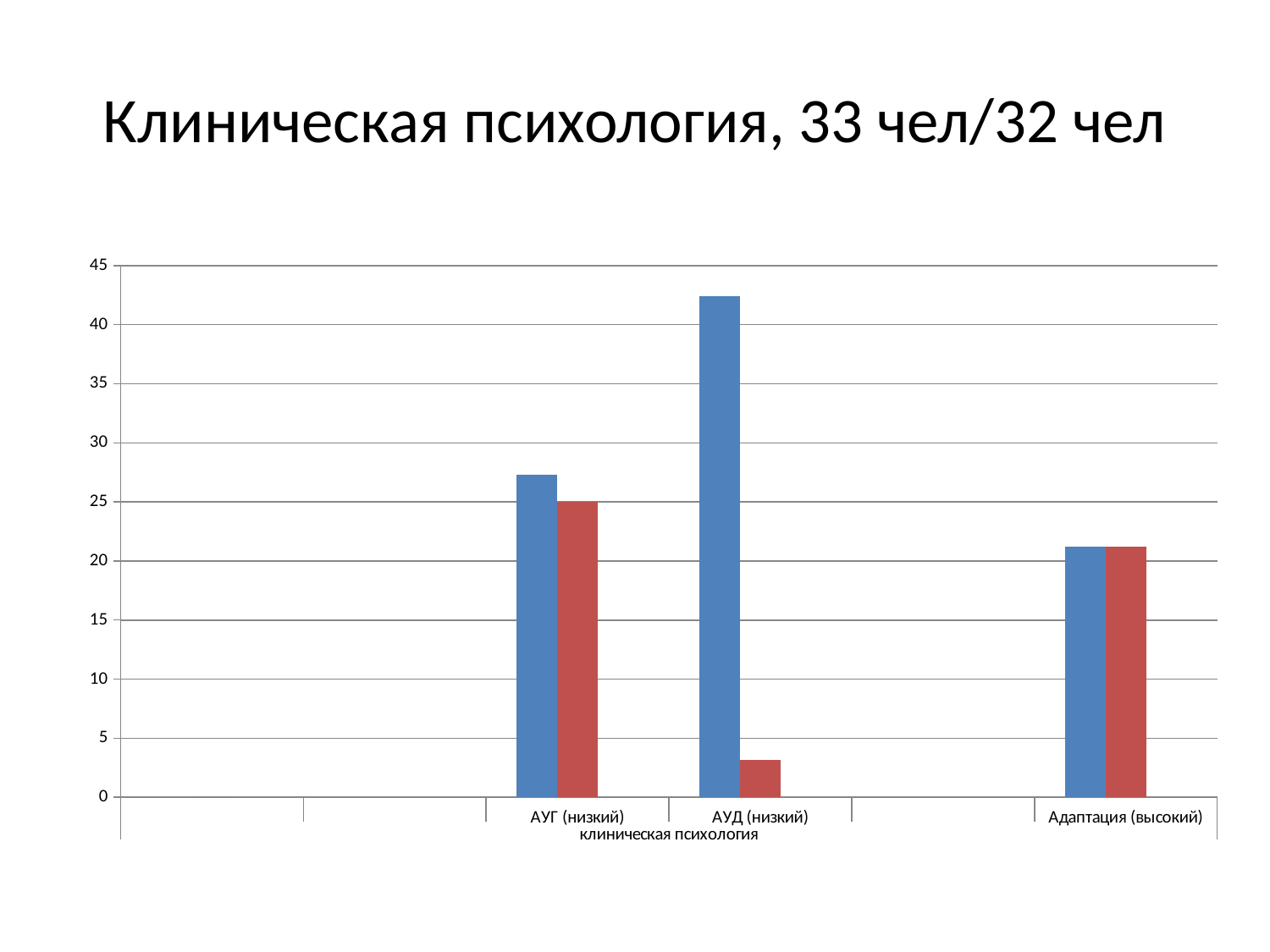
Which category has the tallest blue bar? АУД (низкий) What kind of chart is shown on the slide? Bar chart For АУД (низкий), which bar is taller, the blue one or the red one? The blue one For АУГ (низкий), which bar is taller, the blue one or the red one? The blue one Is the red bar for АУД (низкий) greater or less than 5? less Is the blue bar for АУГ (низкий) greater or less than 30? less What two colours are used for the bars in the chart? Blue and red Which category has the shortest red bar? АУД (низкий) How many labelled categories are shown on the x axis of the chart? 3 Is the blue bar for Адаптация (высокий) greater or less than 25? less What is the title of the slide? Клиническая психология, 33 чел/32 чел